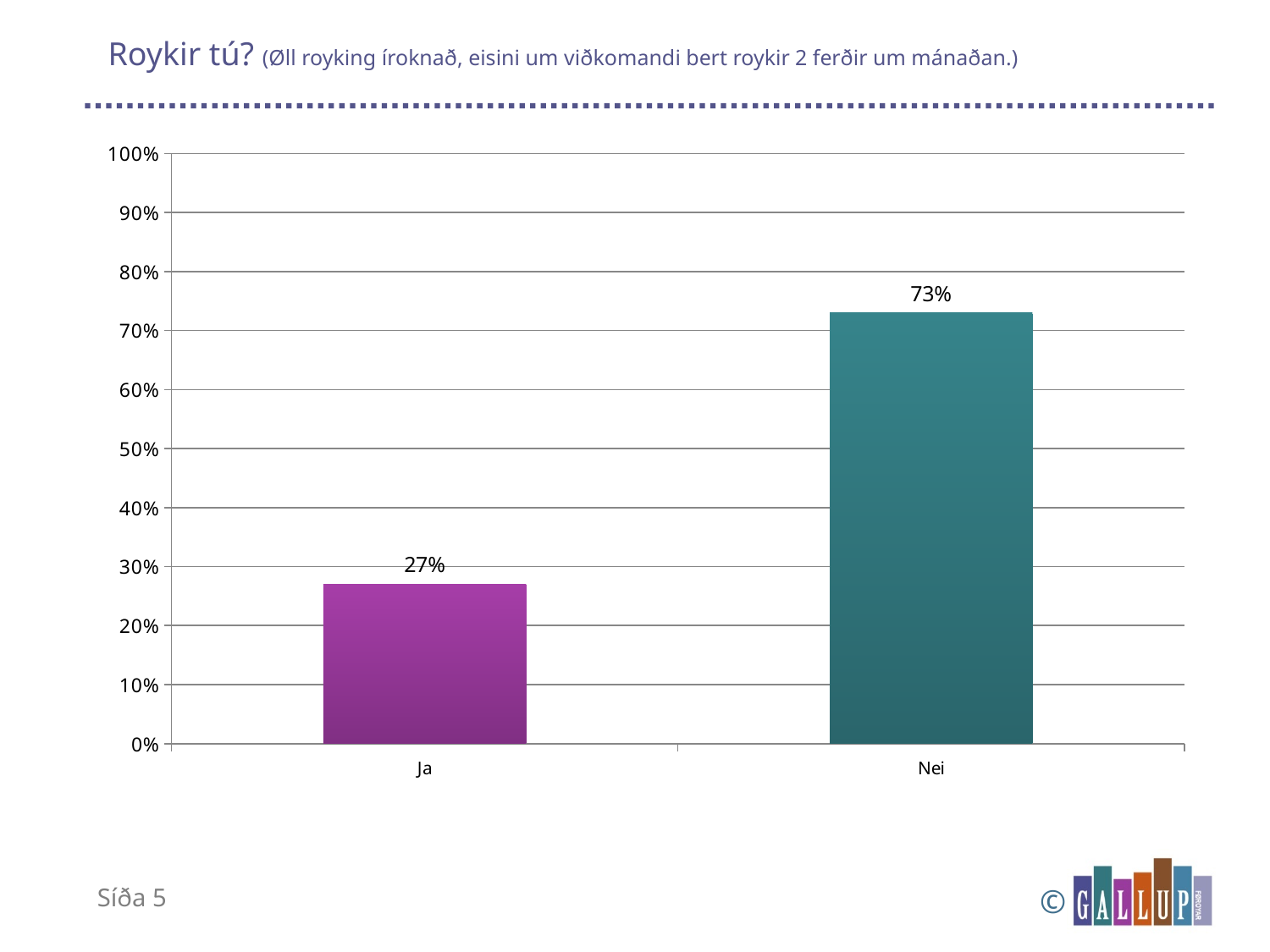
Which category has the lowest value? Ja What is the value for Ja? 27% Is the value for Nei greater or less than 70%? greater Which category has the highest value? Nei What is the value for Nei? 73% What is the difference between the values for Nei and Ja? 46% How many categories are shown on the x axis? 2 Is the value for Ja greater or less than 30%? less What kind of chart is shown on the slide? bar chart What is the total of the two bar values? 100% Which is larger, the value for Ja or the value for Nei? Nei What is the question asked in the slide title? Roykir tú?